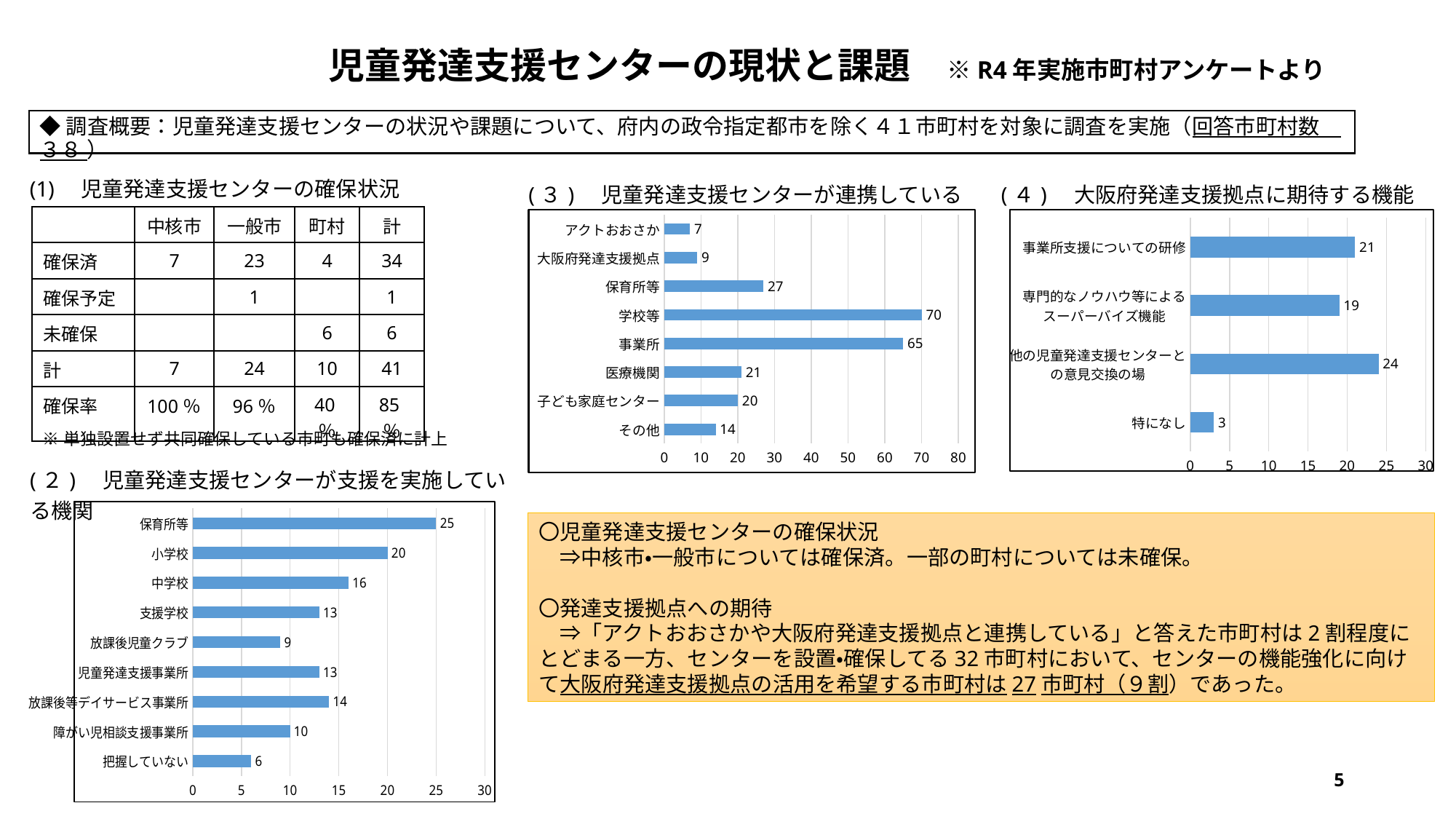
In the chart (3) 児童発達支援センターが連携している, how many categories are plotted? 8 In the chart (3) 児童発達支援センターが連携している, which category has the highest value? 学校等 In the chart (4) 大阪府発達支援拠点に期待する機能, what is the value for 他の児童発達支援センターとの意見交換の場? 24 In the chart (2) 児童発達支援センターが支援を実施している機関, how many categories are plotted? 9 In the chart (3) 児童発達支援センターが連携している, which is larger, 医療機関 or 子ども家庭センター? 医療機関 In the chart (3) 児童発達支援センターが連携している, what is the difference between 学校等 and 事業所? 5 In the chart (2) 児童発達支援センターが支援を実施している機関, what is the value for 保育所等? 25 What kind of chart is the chart (4) 大阪府発達支援拠点に期待する機能? bar chart In the chart (2) 児童発達支援センターが支援を実施している機関, what is the difference between 小学校 and 中学校? 4 In the chart (4) 大阪府発達支援拠点に期待する機能, which category has the lowest value? 特になし In the chart (2) 児童発達支援センターが支援を実施している機関, which category has the lowest value? 把握していない In the chart (3) 児童発達支援センターが連携している, what is the value for 大阪府発達支援拠点? 9